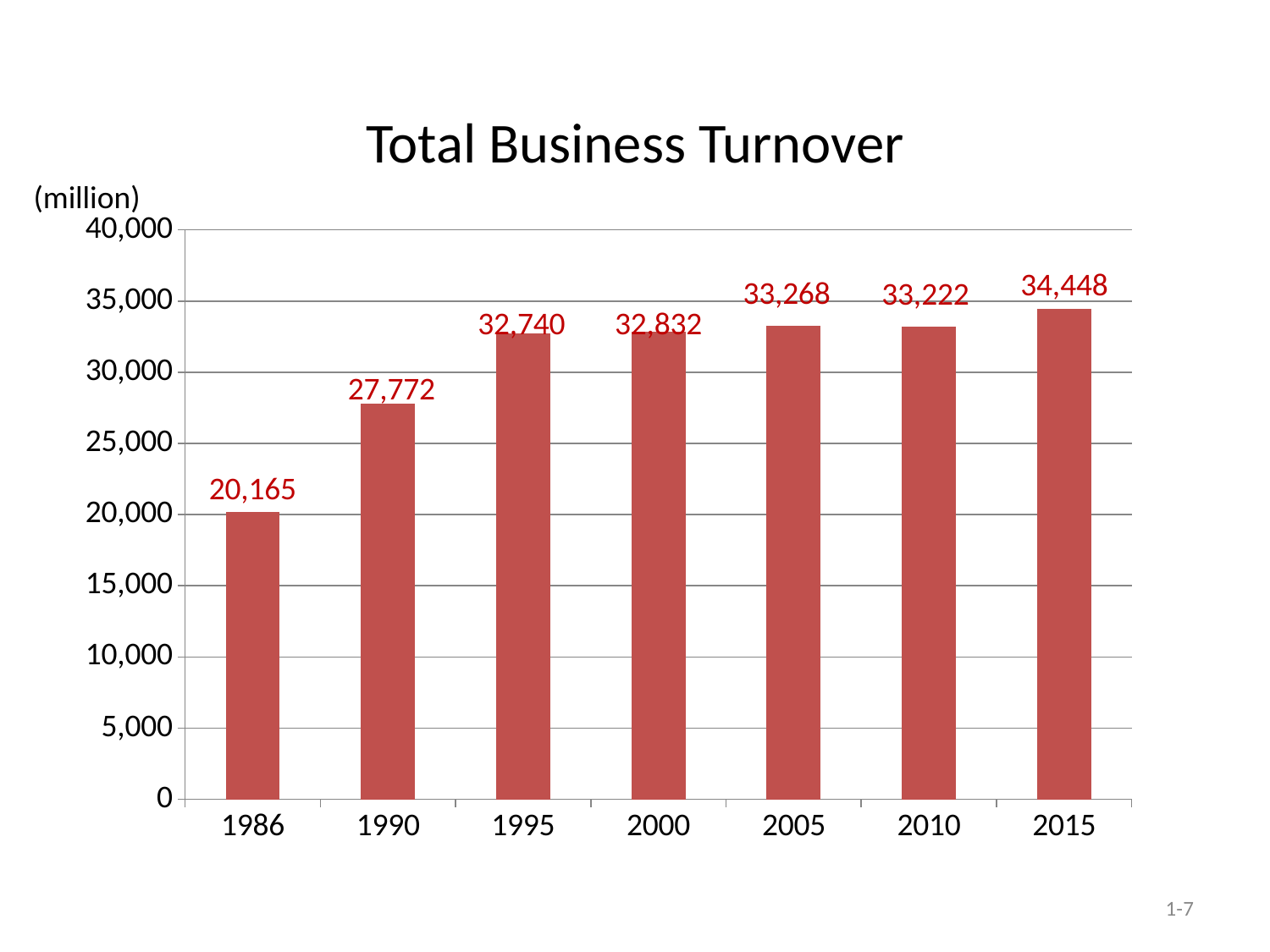
What is the difference in total business turnover between 2015 and 2010? 1,226 How many years are shown on the chart? 7 Which year has the lowest total business turnover? 1986 Which year has the highest total business turnover? 2015 What is the difference in total business turnover between 1990 and 1986? 7,607 What is the total business turnover for 1986? 20,165 Is the value for 1990 greater or less than 25,000? greater Which year has a larger total business turnover, 1995 or 2000? 2000 What is the total business turnover for 2015? 34,448 What is the total business turnover for 2005? 33,268 What unit is indicated for the values on the chart? (million) What kind of chart is shown on the slide? Bar chart